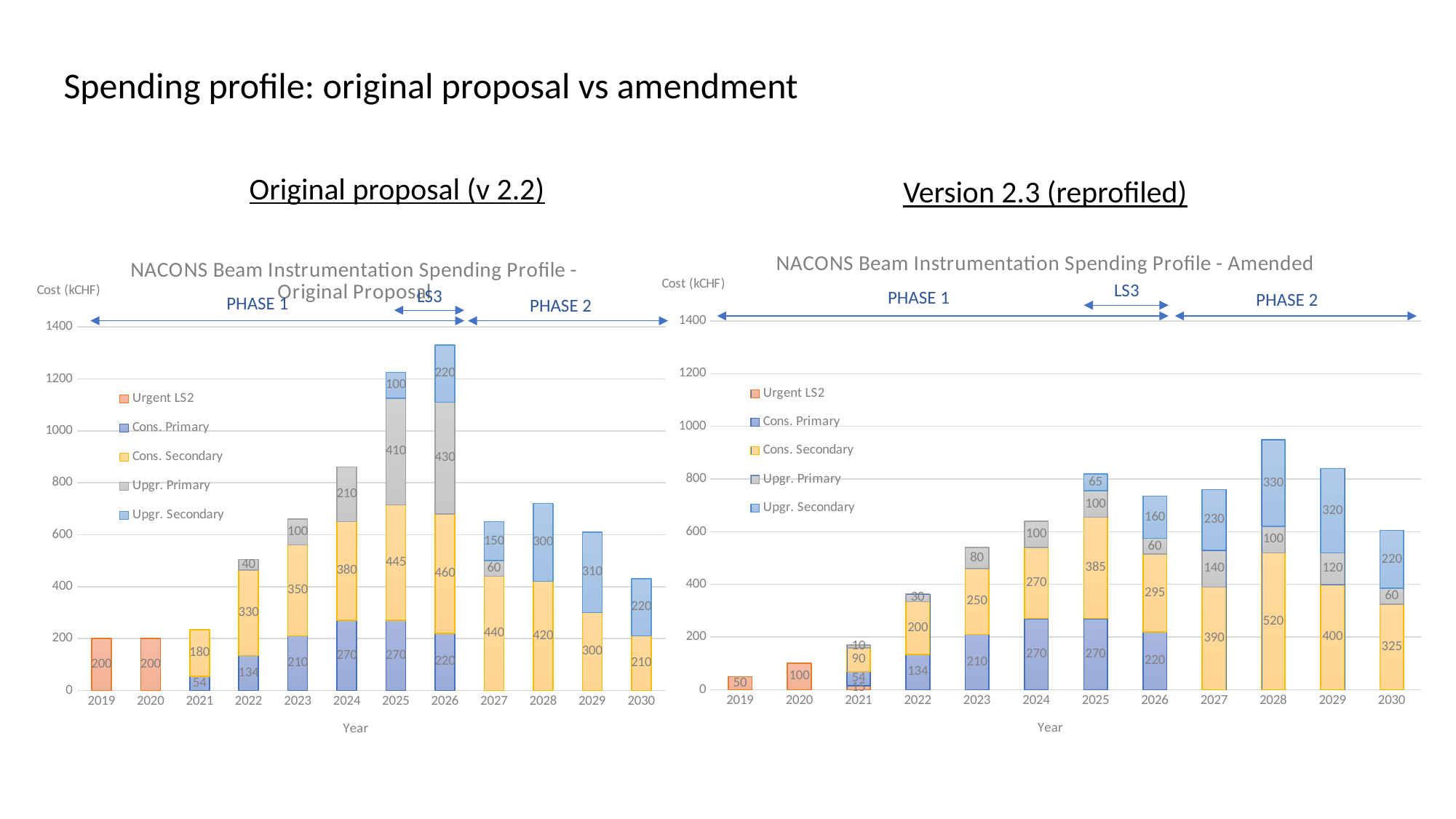
How many years are shown on the x axis of the Original Proposal chart? 12 In the Amended chart, which is larger, the Cons. Secondary value for 2028 or for 2029? 2028 In the Original Proposal chart, what is the difference between the Upgr. Primary values for 2026 and 2025? 20 In the Amended chart, what is the total of the stacked bar for 2028? 950 In the Original Proposal chart, what is the Cons. Secondary value for 2026? 460 What kind of chart is the Amended chart? Stacked bar chart In the Original Proposal chart, what is the total of the stacked bar for 2026? 1330 In the Original Proposal chart, which year has the tallest stacked bar? 2026 In the Amended chart, what is the Urgent LS2 value for 2019? 50 In the Amended chart, which year has the tallest stacked bar? 2028 In the Amended chart, what is the Upgr. Secondary value for 2028? 330 How many series does the legend of the Amended chart list? 5